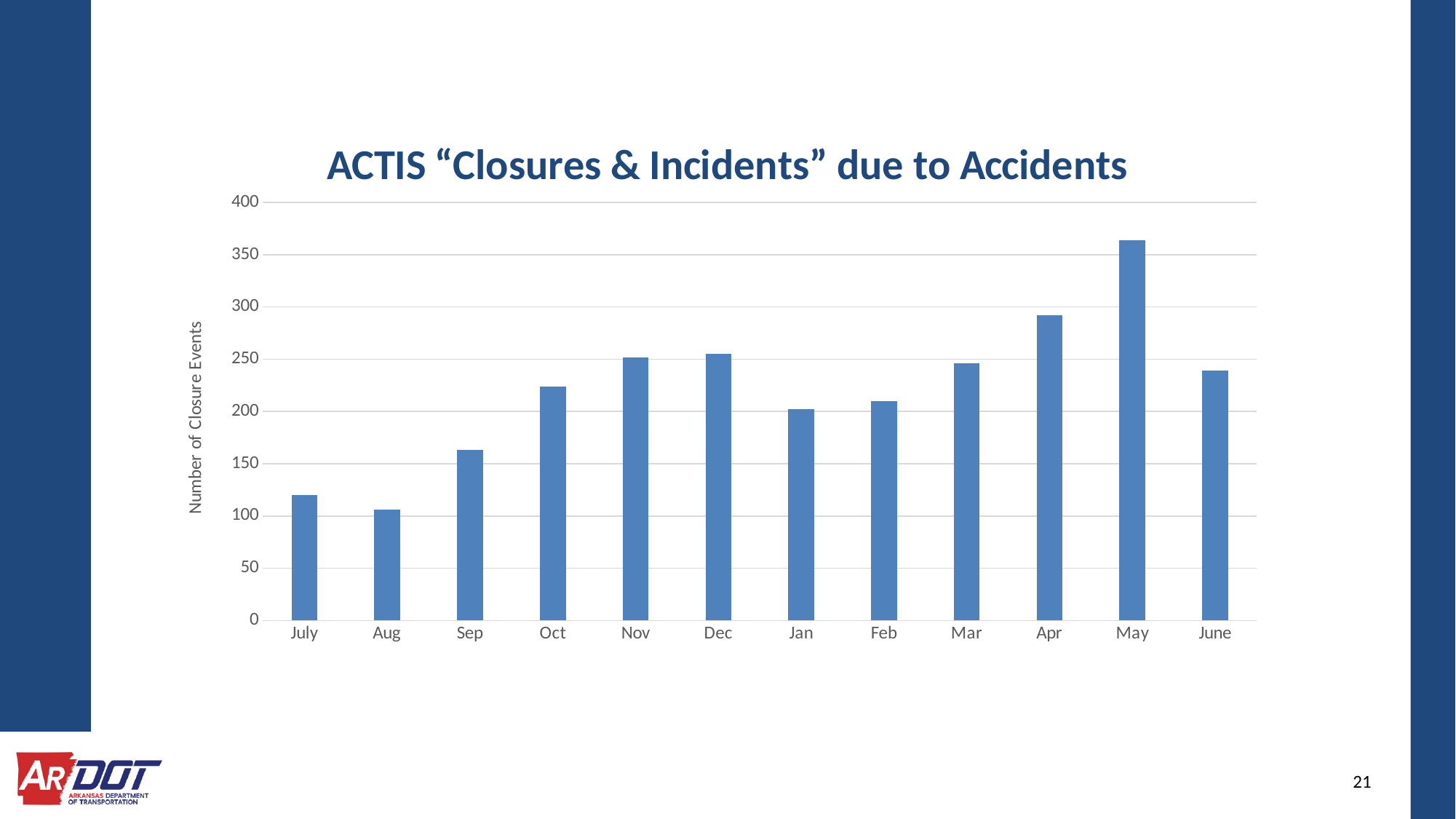
Is the value for Oct greater or less than 250? less What type of chart is shown on the slide? Bar chart What is the label on the vertical axis of the chart? Number of Closure Events Is the value for May greater or less than 350? greater How many months are plotted on the chart? 12 Is the value for Sep greater or less than 150? greater Which month has more closure events, Apr or Mar? Apr Which month has the lowest number of closure events? Aug Which month has the highest number of closure events? May